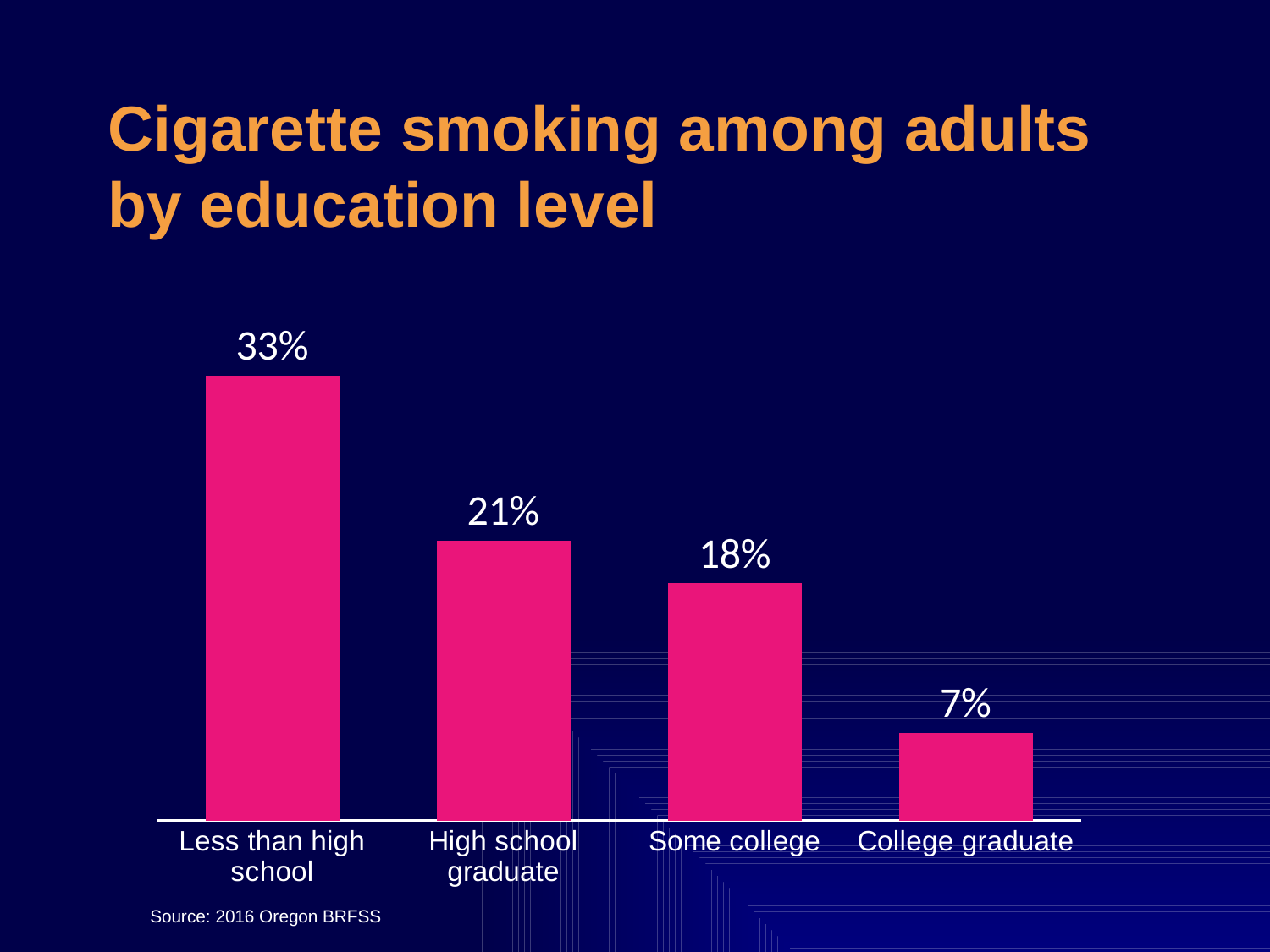
What is the difference in smoking rate between adults with less than high school education and college graduates? 26% What is the cigarette smoking rate for adults with less than high school education? 33% Which education level has the highest cigarette smoking rate? Less than high school What kind of chart is shown on the slide? Bar chart Do the smoking rates rise or fall as education level increases from left to right? Fall Which education level has the lowest cigarette smoking rate? College graduate How many education levels are shown in the chart? 4 What is the cigarette smoking rate for adults with some college? 18% What is the cigarette smoking rate for high school graduates? 21% What is the difference in smoking rate between high school graduates and adults with some college? 3% Which group has a higher smoking rate: high school graduates or college graduates? High school graduate What is the cigarette smoking rate for college graduates? 7%